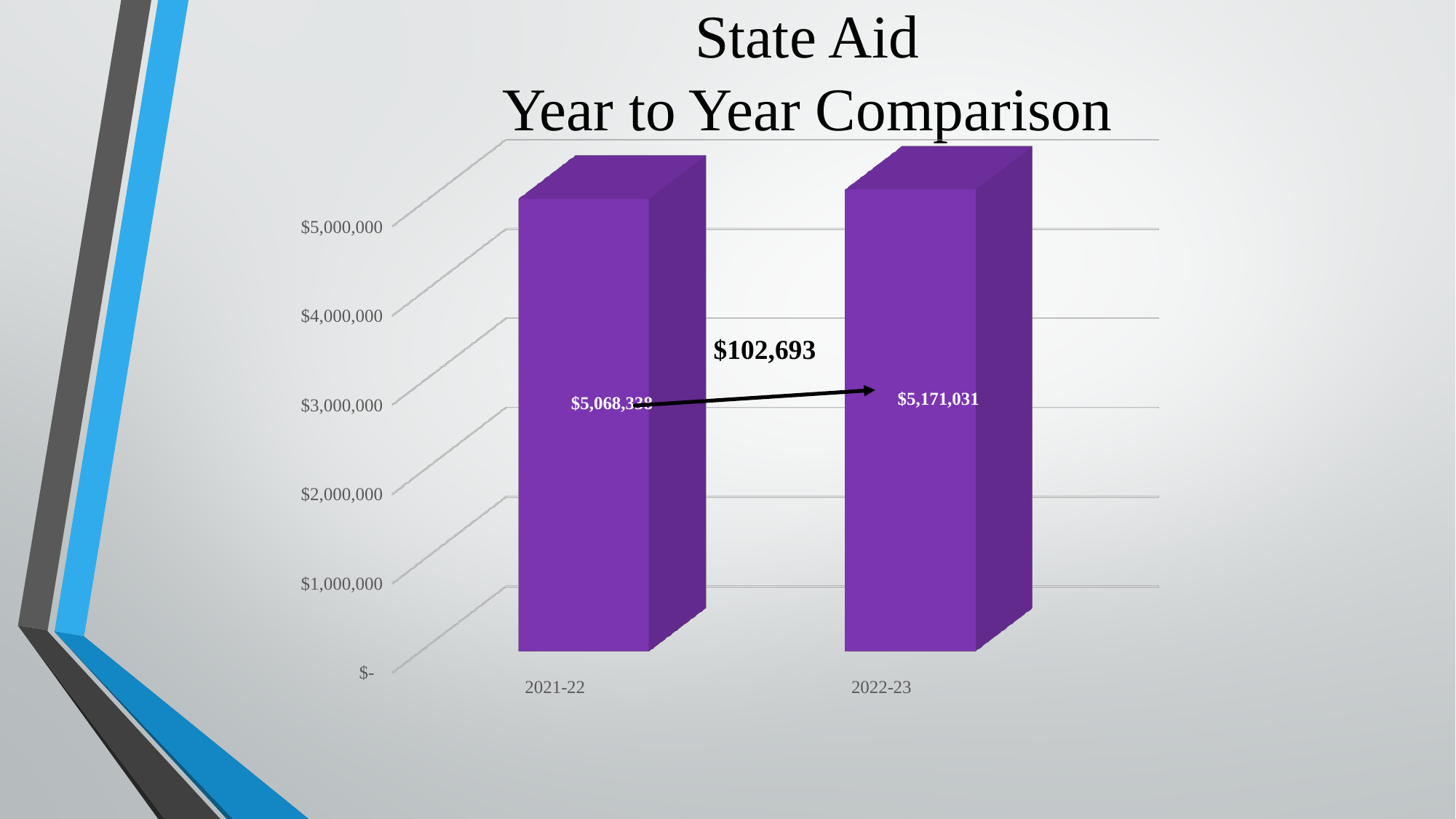
What is the State Aid value for 2021-22? $5,068,338 What colour are the bars in the chart? purple Is the value for 2021-22 greater or less than $5,000,000? greater Is the State Aid value for 2022-23 larger or smaller than the value for 2021-22? larger How many years (bars) are shown on the chart? 2 What is the State Aid value for 2022-23? $5,171,031 What is the title of the chart? State Aid Year to Year Comparison What is the difference in State Aid between 2022-23 and 2021-22, as annotated on the chart? $102,693 Does the State Aid value rise or fall from 2021-22 to 2022-23? rise What kind of chart is shown on the slide? bar chart Which year has the higher State Aid value? 2022-23 Which year has the lower State Aid value? 2021-22